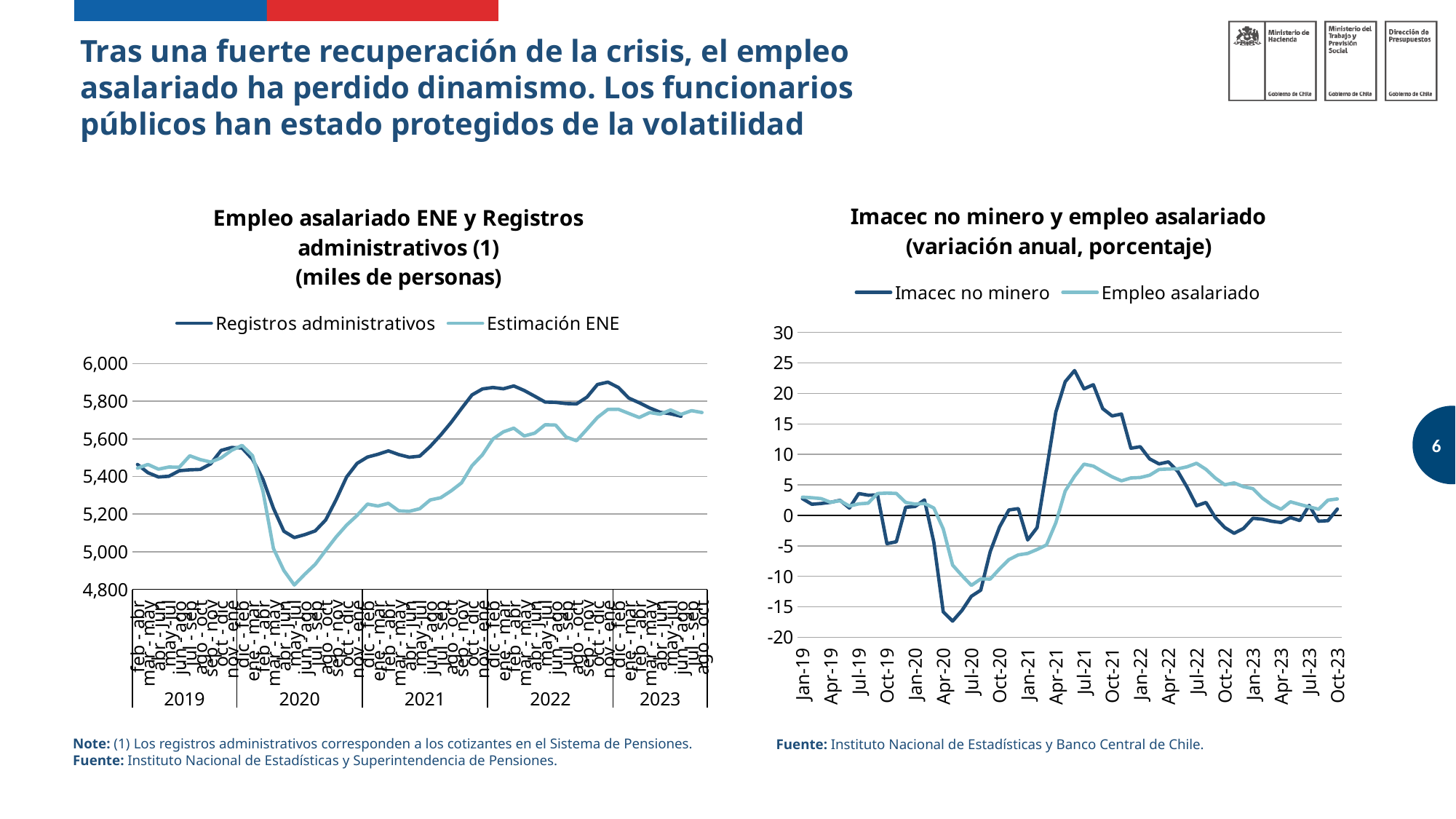
In the left chart 'Empleo asalariado ENE y Registros administrativos (1)', is the lowest value of the Registros administrativos series in 2020 greater or less than 5,000? greater In the left chart 'Empleo asalariado ENE y Registros administrativos (1)', is the highest value of the Registros administrativos series greater or less than 6,000? less In the right chart 'Imacec no minero y empleo asalariado', how many series does the legend list? 2 In the right chart 'Imacec no minero y empleo asalariado', is the lowest value of Imacec no minero around Apr-20 greater or less than -15? less In the right chart 'Imacec no minero y empleo asalariado', what unit is stated in the title for the values? variación anual, porcentaje In the left chart 'Empleo asalariado ENE y Registros administrativos (1)', how many series does the legend list? 2 In the left chart 'Empleo asalariado ENE y Registros administrativos (1)', what are the two series named in the legend? Registros administrativos and Estimación ENE What kind of chart is the right chart titled 'Imacec no minero y empleo asalariado'? line chart What kind of chart is the left chart titled 'Empleo asalariado ENE y Registros administrativos (1)'? line chart